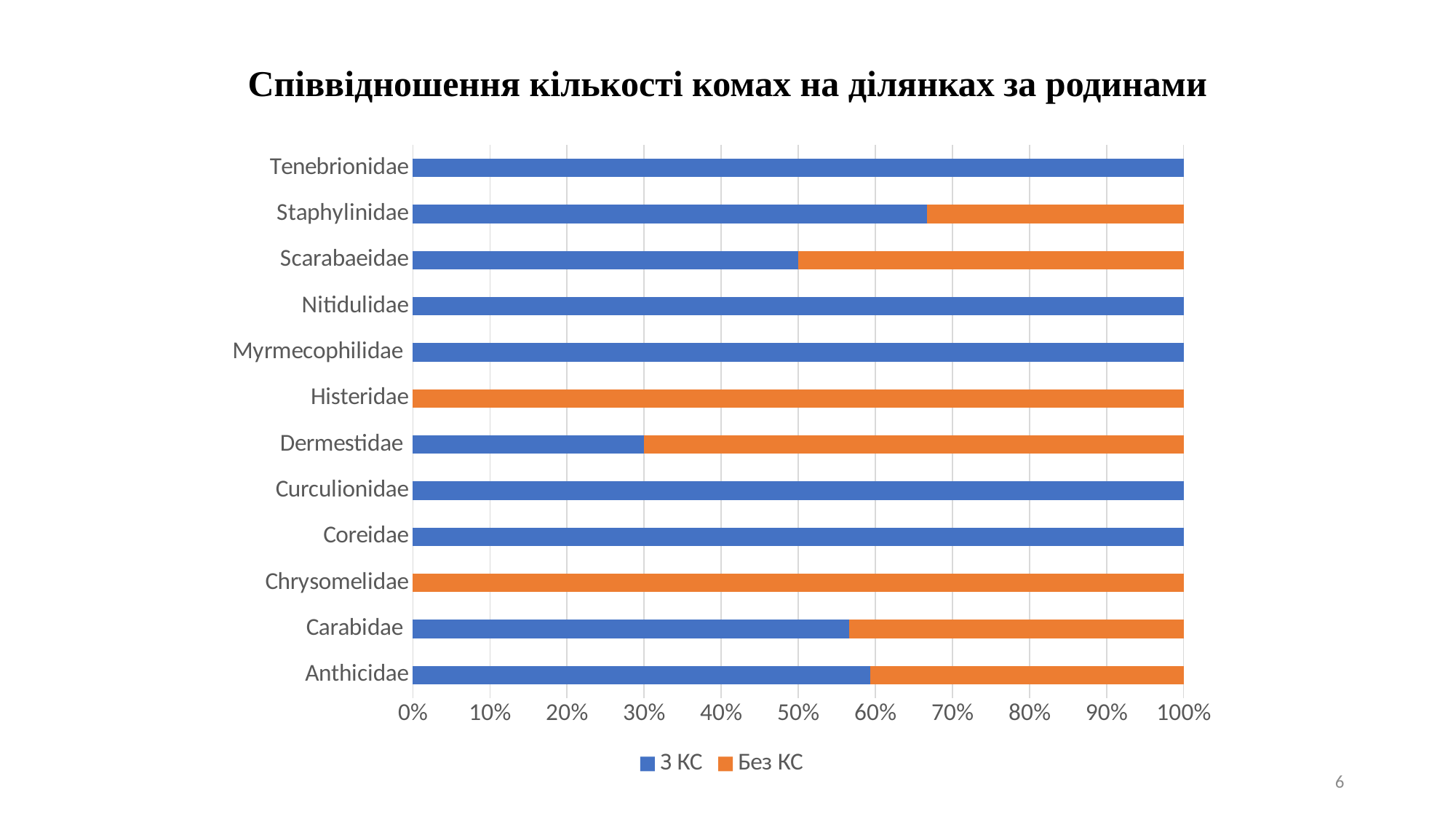
What is the share of "З КС" for Scarabaeidae? 50% Which family has the larger "З КС" share, Anthicidae or Dermestidae? Anthicidae How many series does the legend list? 2 Is the "З КС" share for Staphylinidae greater or less than 60%? greater What kind of chart is shown on the slide? bar chart What are the two entries in the chart legend? З КС, Без КС How many families have a bar made up entirely of "Без КС"? 2 Is the "З КС" share for Carabidae greater or less than 50%? greater How many families (categories) are plotted on the chart? 12 What is the share of "Без КС" for Histeridae? 100% What is the share of "З КС" for Tenebrionidae? 100% What is the share of "З КС" for Dermestidae? 30%